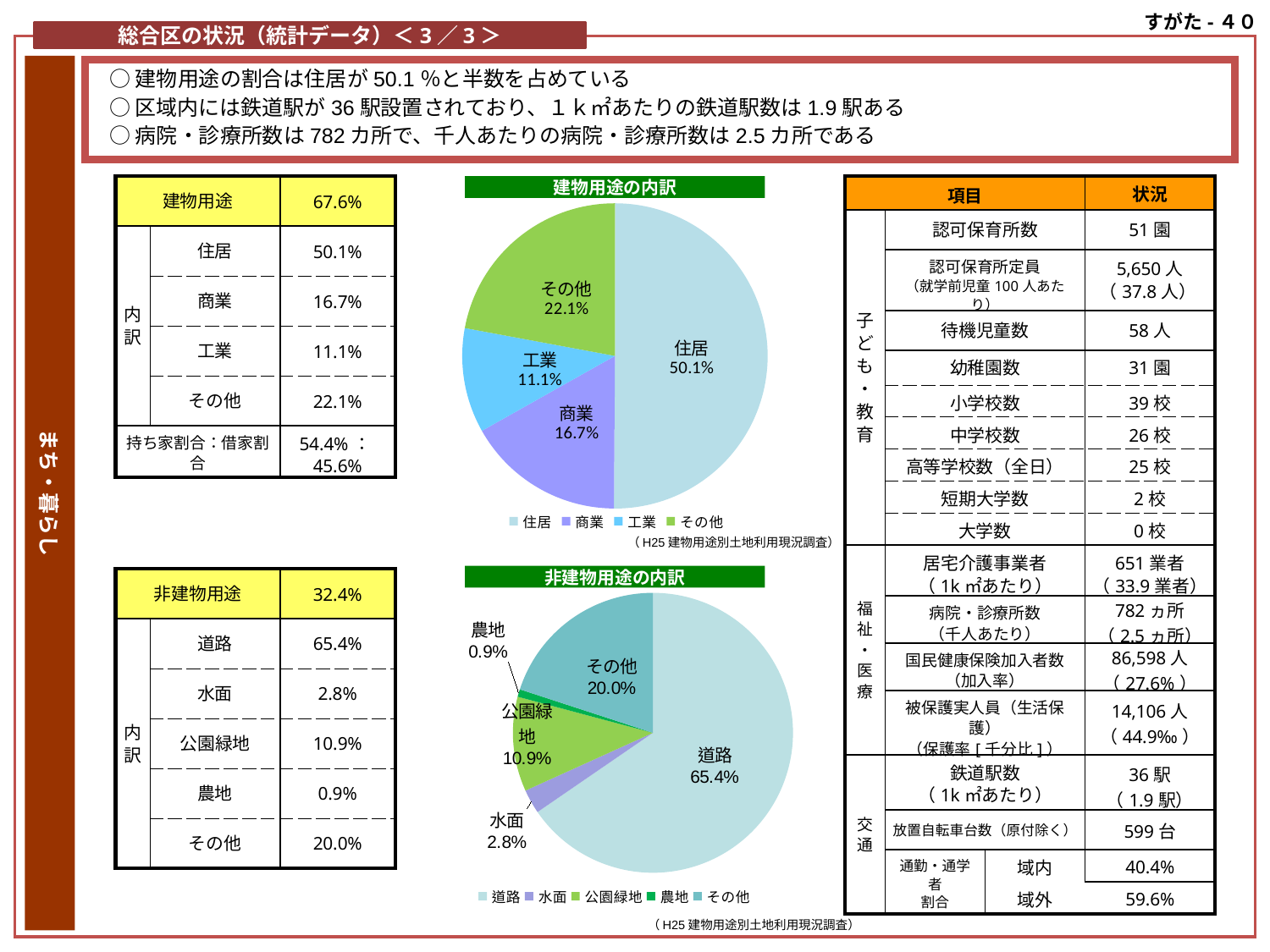
In the 建物用途の内訳 pie chart, what is the share for 工業? 11.1% In the 非建物用途の内訳 pie chart, what is the share for 道路? 65.4% In the 建物用途の内訳 pie chart, what is the share for 住居? 50.1% In the 建物用途の内訳 pie chart, what is the difference between the shares of その他 and 商業? 5.4% In the 建物用途の内訳 pie chart, which category has the smallest share? 工業 In the 建物用途の内訳 pie chart, which category has the largest share? 住居 In the 非建物用途の内訳 pie chart, which category has the smallest share? 農地 What type of chart is the 非建物用途の内訳 chart? Pie chart In the 非建物用途の内訳 pie chart, what is the share for 公園緑地? 10.9% In the 非建物用途の内訳 pie chart, which is larger, 水面 or 公園緑地? 公園緑地 In the 建物用途の内訳 pie chart, how many categories are shown? 4 In the 非建物用途の内訳 pie chart, how many entries does the legend list? 5